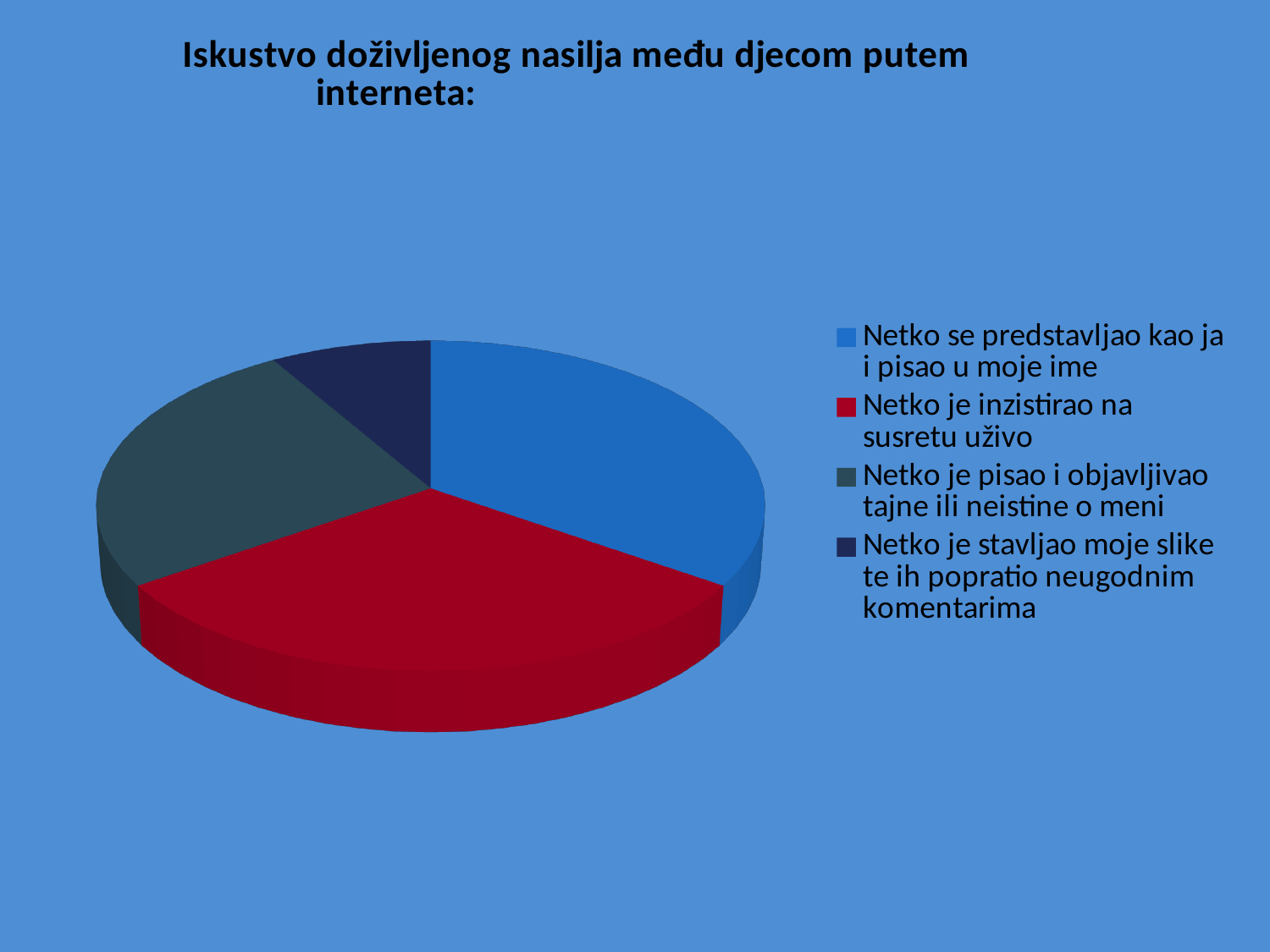
Which category is shown in red in the pie chart? Netko je inzistirao na susretu uživo How many entries does the legend list? 4 What is the title of the chart? Iskustvo doživljenog nasilja među djecom putem interneta: What kind of chart is shown on the slide? pie chart Which slice is larger: "Netko je inzistirao na susretu uživo" or "Netko je stavljao moje slike te ih popratio neugodnim komentarima"? Netko je inzistirao na susretu uživo Which slice is larger: "Netko se predstavljao kao ja i pisao u moje ime" or "Netko je stavljao moje slike te ih popratio neugodnim komentarima"? Netko se predstavljao kao ja i pisao u moje ime How many slices does the pie chart have? 4 Which category has the smallest slice of the pie? Netko je stavljao moje slike te ih popratio neugodnim komentarima Which slice is larger: "Netko je pisao i objavljivao tajne ili neistine o meni" or "Netko je stavljao moje slike te ih popratio neugodnim komentarima"? Netko je pisao i objavljivao tajne ili neistine o meni